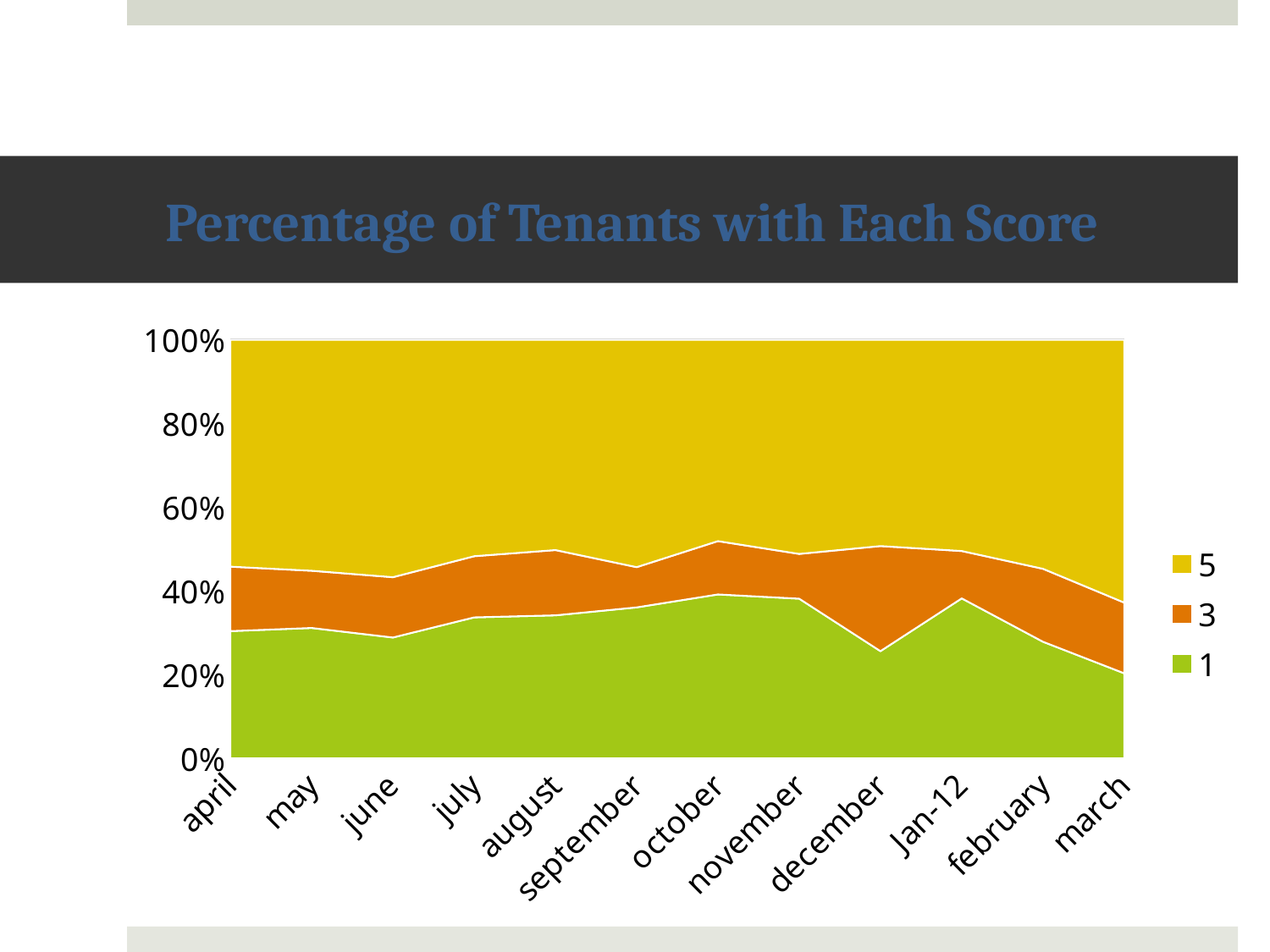
How many months are shown along the x axis? 12 Is the value for series 1 in december greater or less than 40%? less What is the title of the chart? Percentage of Tenants with Each Score In which month is the value for series 1 lowest? march What kind of chart is shown on the slide? Stacked area chart Is the value for series 5 in april greater or less than 40%? greater How many series does the legend list? 3 Which series is shown in green? 1 Which is larger for series 1: the value in october or the value in june? october Is the value for series 1 in april greater or less than 20%? greater Does the value for series 1 rise or fall from Jan-12 to march? fall